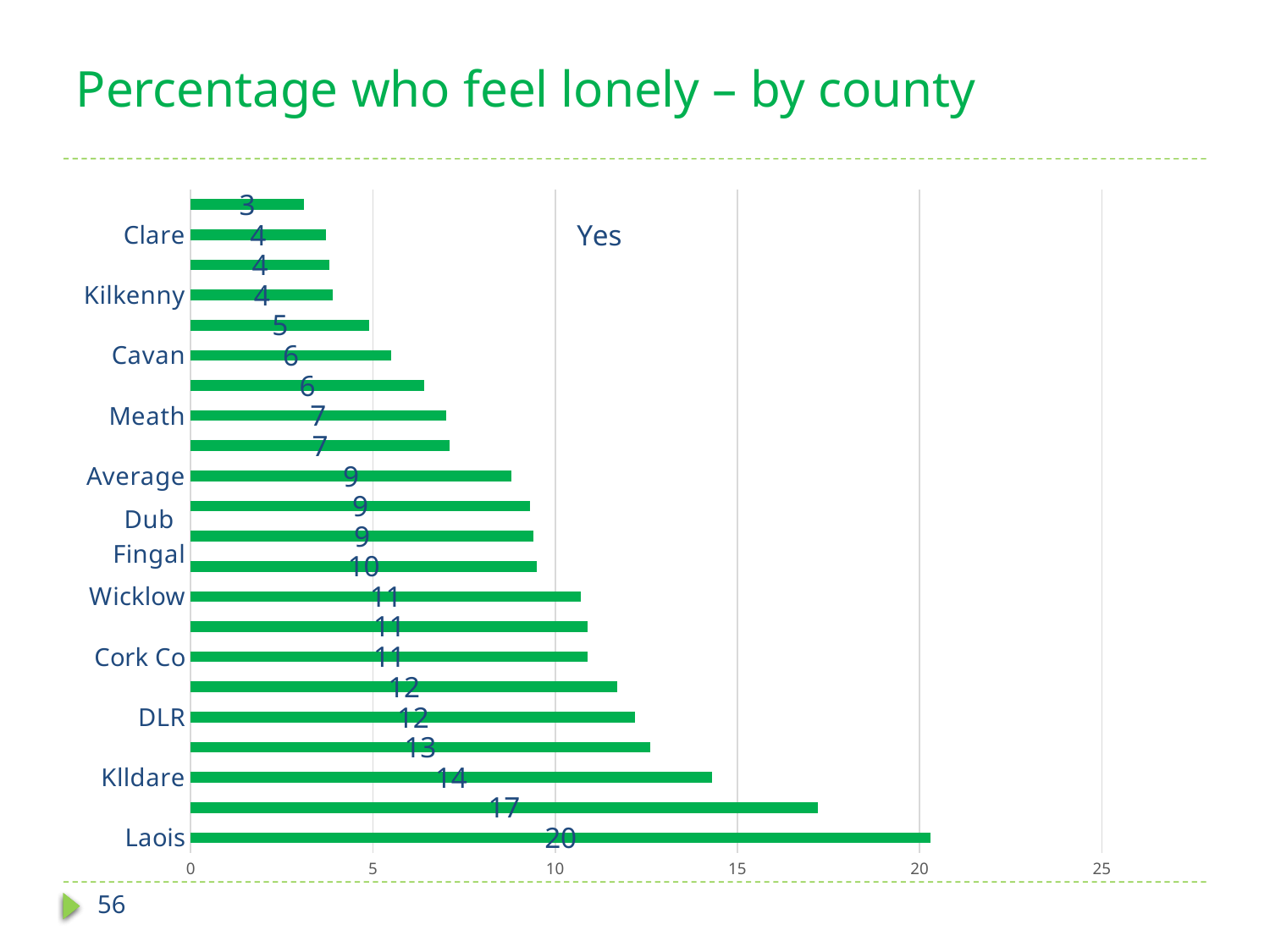
Which labelled county has the highest percentage who feel lonely? Laois What is the smallest value labelled on any bar in the chart? 3 What is the value shown for Cavan? 6 Which has a larger value, Meath or Wicklow? Wicklow What is the percentage who feel lonely in Laois? 20 What is the value shown for DLR? 12 What is the value shown for Kildare? 14 What is the value shown for the Average? 9 What is the difference between the values for Laois and Kildare? 6 What kind of chart is shown on the slide? bar chart Is the value for Laois greater or less than 15? greater